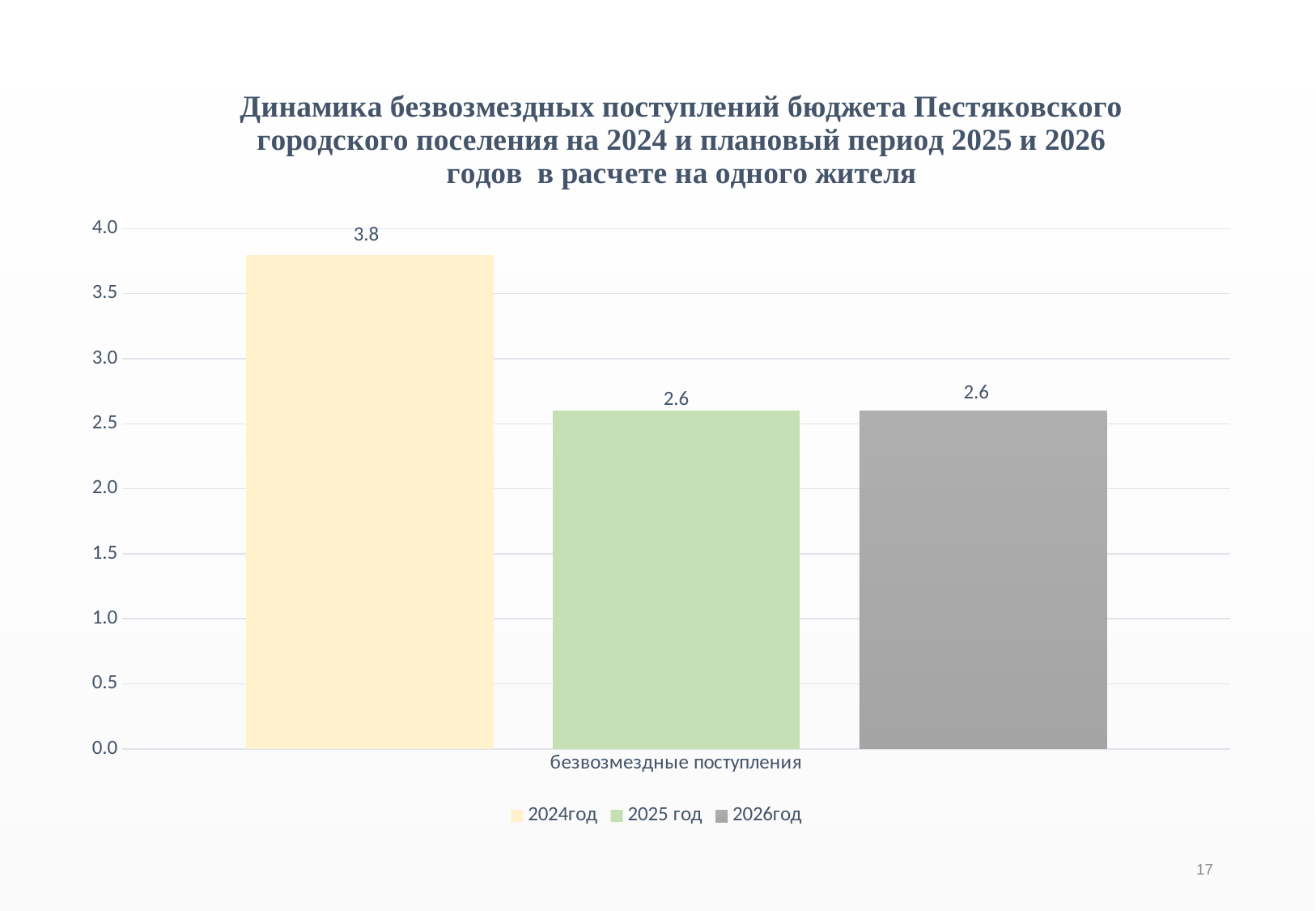
Which is larger, the value for 2024год or the value for 2026год? 2024год What is the value for 2024год? 3.8 What is the value for 2026год? 2.6 Is the value for 2025 год greater or less than 3.0? less What kind of chart is shown on the slide? bar chart What is the value for 2025 год? 2.6 Do the values rise or fall from 2024год to 2026год? fall How many series does the legend list? 3 What is the difference between the values for 2024год and 2025 год? 1.2 Is the value for 2024год greater or less than 3.5? greater What is the category label shown on the x axis? безвозмездные поступления Which series has the highest value? 2024год